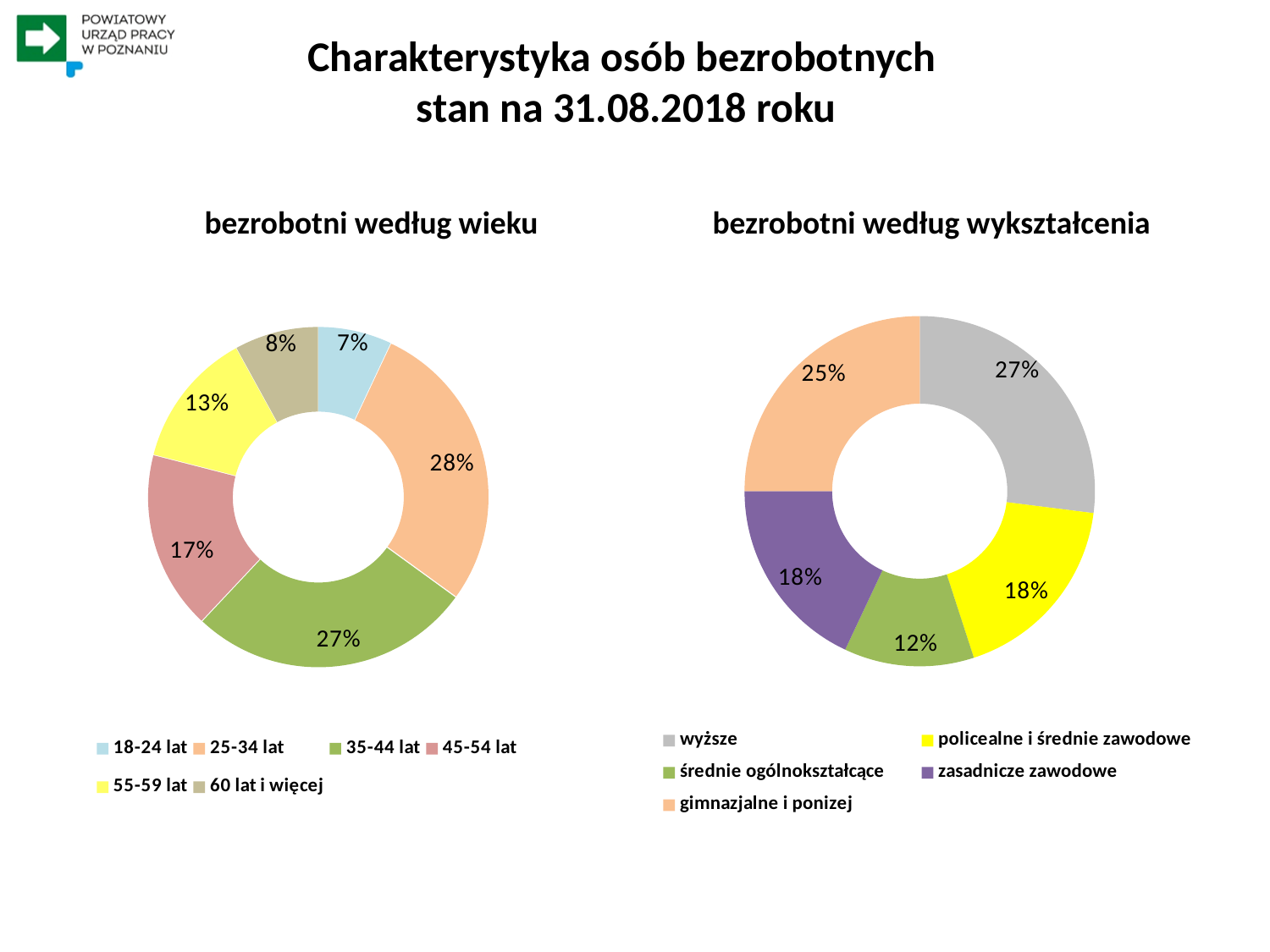
In the 'bezrobotni według wykształcenia' chart, what share is shown for gimnazjalne i poniżej? 25% In the 'bezrobotni według wieku' chart, which age group has the smallest share? 18-24 lat In the 'bezrobotni według wykształcenia' chart, which education level has the smallest share? średnie ogólnokształcące What type of chart is the 'bezrobotni według wykształcenia' chart? Doughnut (pie) chart In the 'bezrobotni według wieku' chart, what is the difference between the shares for 55-59 lat and 60 lat i więcej? 5 percentage points In the 'bezrobotni według wieku' chart, which age group has the largest share? 25-34 lat In the 'bezrobotni według wykształcenia' chart, what share is shown for wyższe? 27% In the 'bezrobotni według wieku' chart, what share is shown for the 45-54 lat group? 17% In the 'bezrobotni według wykształcenia' chart, which is larger: the share for wyższe or the share for zasadnicze zawodowe? wyższe How many categories does the 'bezrobotni według wykształcenia' chart show? 5 In the 'bezrobotni według wieku' chart, what share is shown for the 25-34 lat group? 28% How many categories does the 'bezrobotni według wieku' chart show? 6